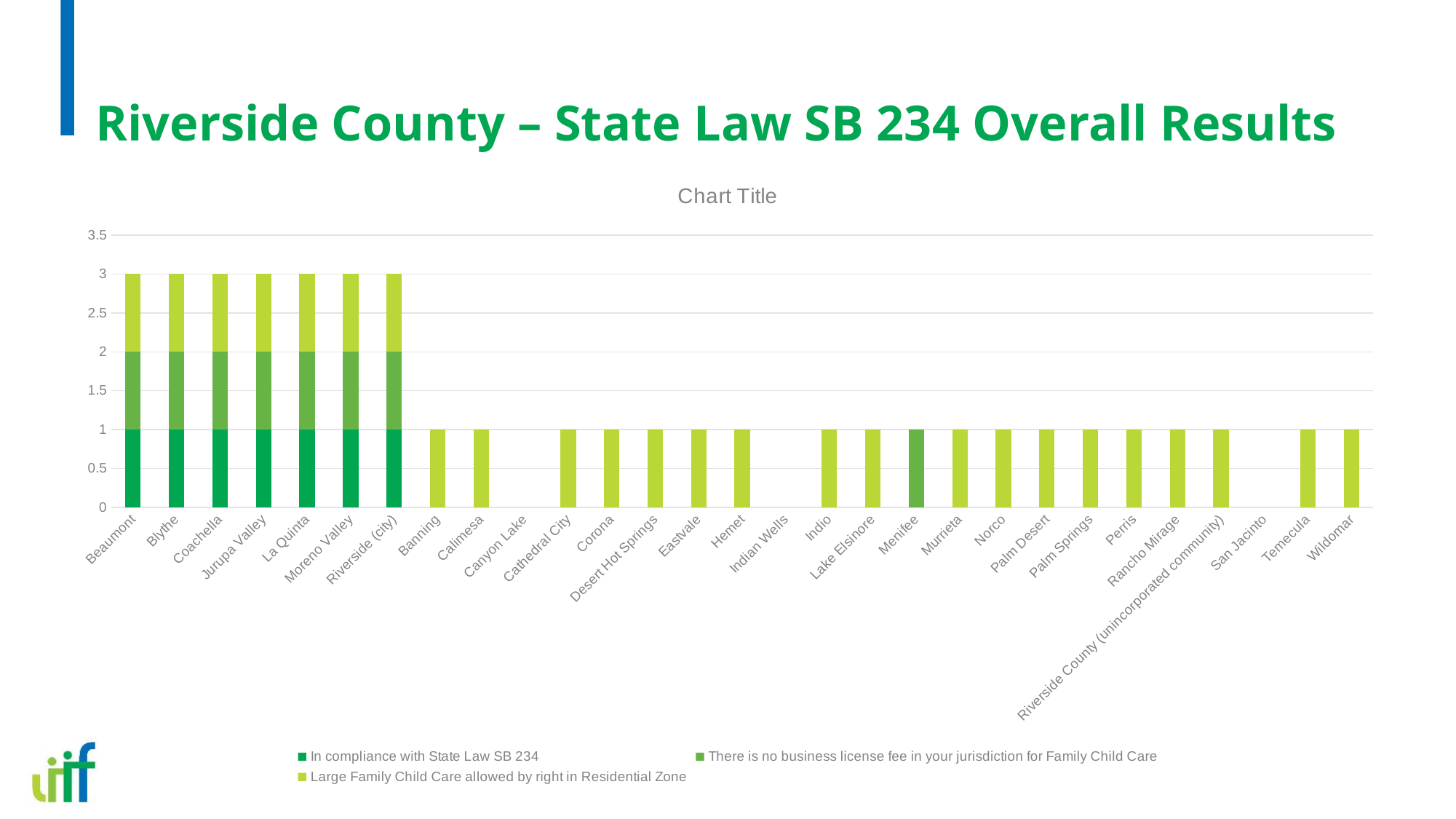
Is the total for Moreno Valley greater or less than 2? greater What is the difference between the total for La Quinta and the total for Temecula? 2 Is the total for Riverside (city) larger than the total for Corona? Yes Which jurisdictions have no bar at all (a total of 0)? Canyon Lake, Indian Wells, San Jacinto How many jurisdictions have a stacked bar reaching 3? 7 What kind of chart is shown on the slide? stacked bar chart What is the total height of the stacked bar for Banning? 1 What is the title printed above the chart? Chart Title How many jurisdictions are listed along the x axis? 29 Which series is shown for Menifee? There is no business license fee in your jurisdiction for Family Child Care How many series does the legend list? 3 What is the total height of the stacked bar for Beaumont? 3